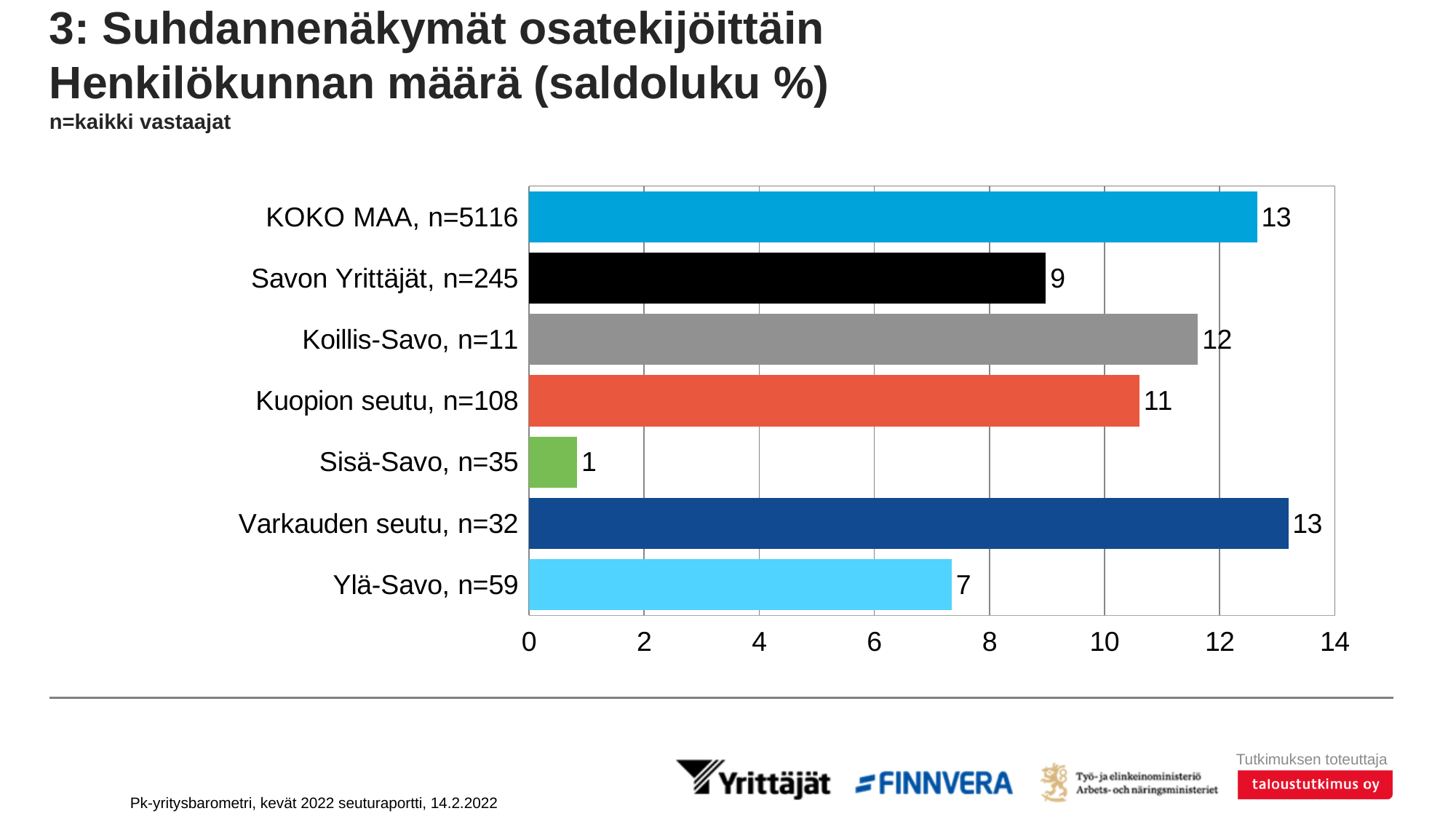
What is the difference between the values for Koillis-Savo, n=11 and Ylä-Savo, n=59? 5 What kind of chart is shown on the slide? bar chart How many categories are shown in the chart? 7 What is the difference between the values for KOKO MAA, n=5116 and Savon Yrittäjät, n=245? 4 What is the value for Koillis-Savo, n=11? 12 What is the value for Ylä-Savo, n=59? 7 Which is larger, the value for Kuopion seutu, n=108 or the value for Ylä-Savo, n=59? Kuopion seutu, n=108 Which category has the lowest value? Sisä-Savo, n=35 What is the value for Kuopion seutu, n=108? 11 What colour is the bar for Sisä-Savo, n=35? green Is the value for Varkauden seutu, n=32 greater or less than 10? greater What is the value for Savon Yrittäjät, n=245? 9